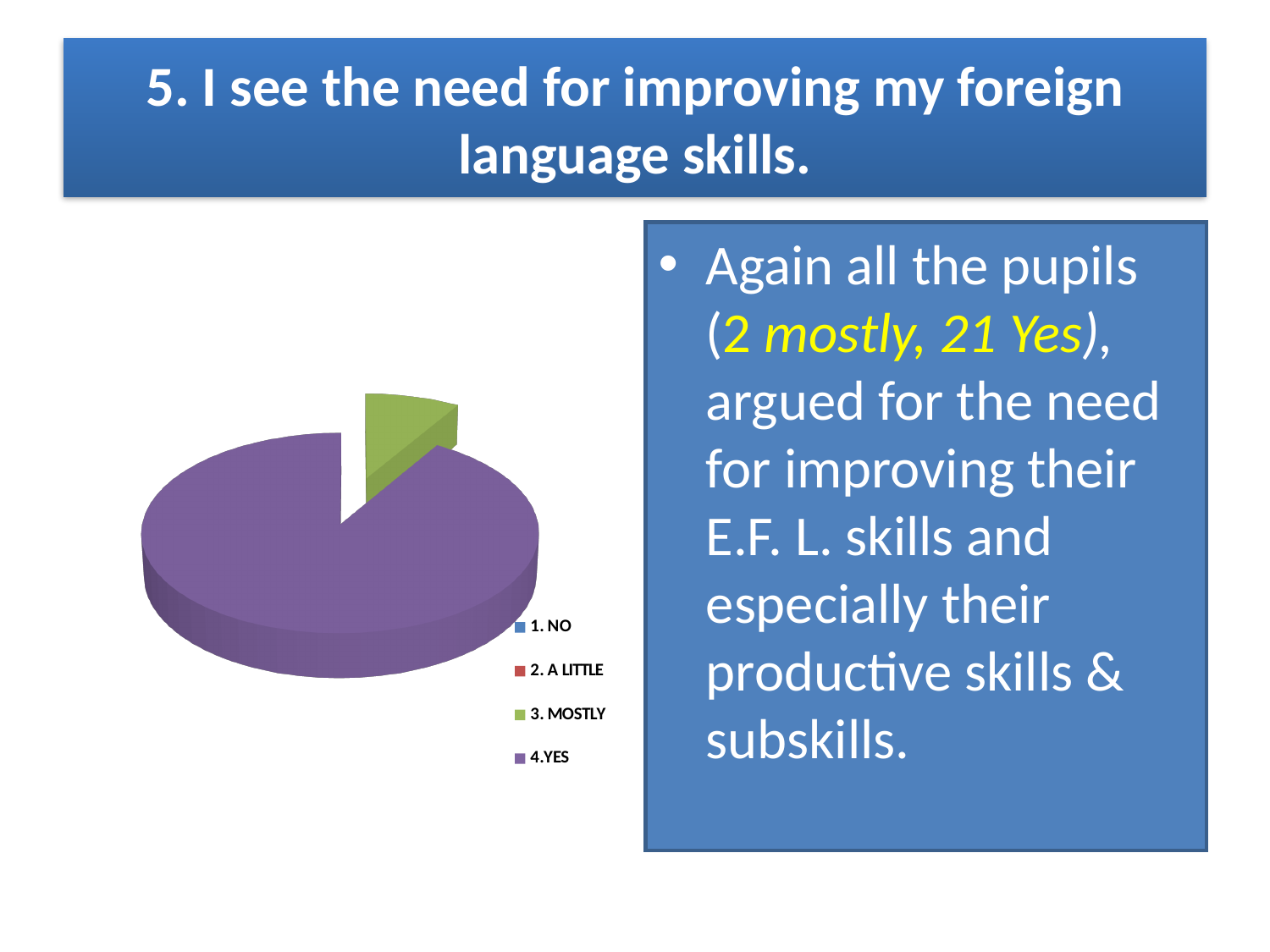
How many categories does the legend of the pie chart list? 4 Does the 3. MOSTLY slice take up more or less than a quarter of the pie? less What colour is the slice for 4.YES in the pie chart? purple What colour is the slice for 3. MOSTLY in the pie chart? green What kind of chart is shown on the slide? pie chart Which is larger, the slice for 4.YES or the slice for 3. MOSTLY? 4.YES Which legend entry is listed first in the pie chart's legend? 1. NO Which category has the largest slice of the pie? 4.YES Does the 4.YES slice take up more or less than half of the pie? more